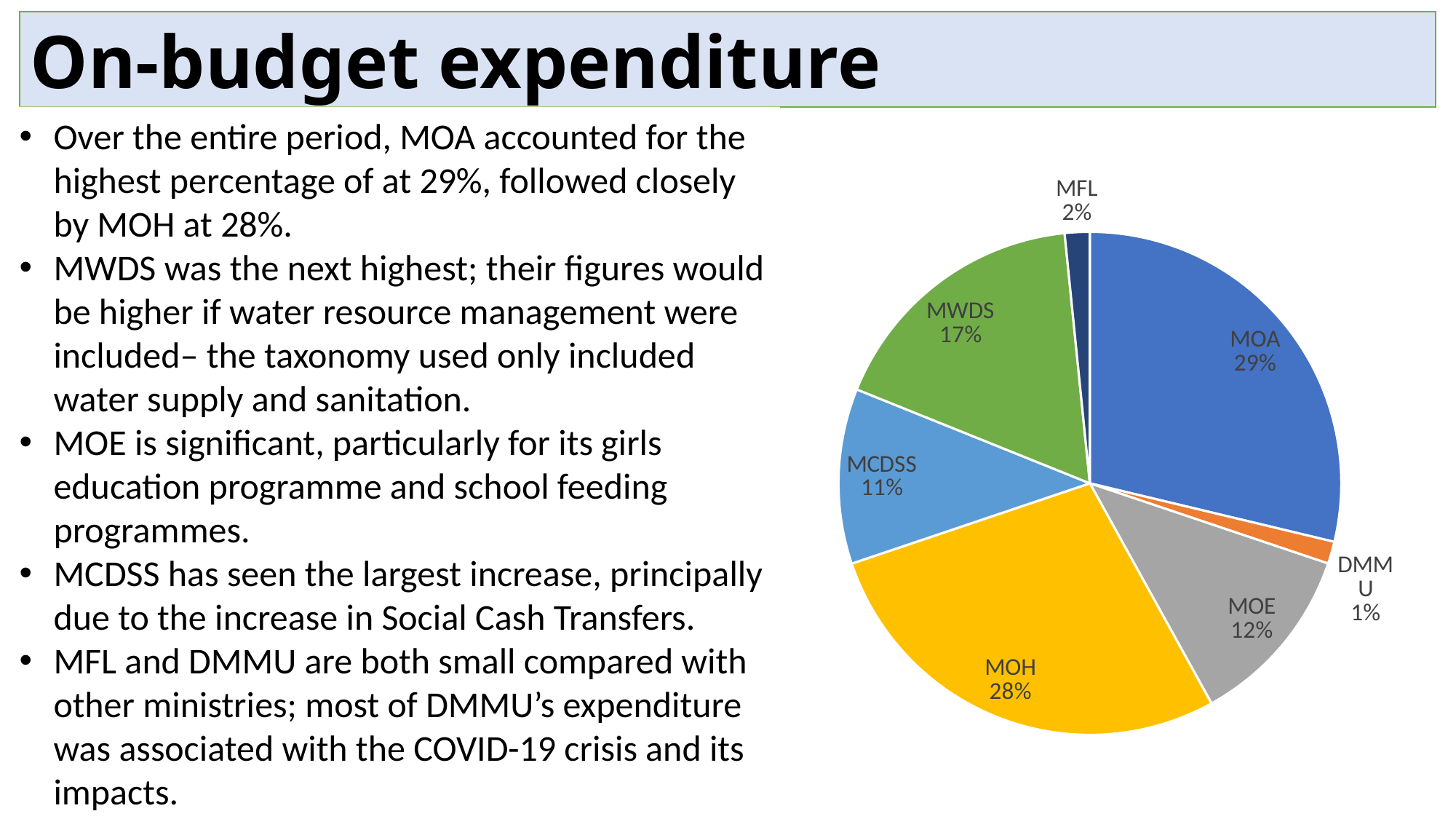
What kind of chart is shown on the slide? pie chart What percentage is shown for DMMU? 1% What percentage is shown for MCDSS? 11% What share of the pie does MOA account for? 29% What percentage is shown for MWDS? 17% Which ministry has the smallest slice of the pie? DMMU What is the difference in percentage points between MOA and MOH? 1% What percentage is shown for MOH? 28% What is the difference in percentage points between MWDS and MFL? 15% Which is larger, the share for MOE or the share for MCDSS? MOE How many slices does the pie chart have? 7 Which ministry has the largest slice of the pie? MOA